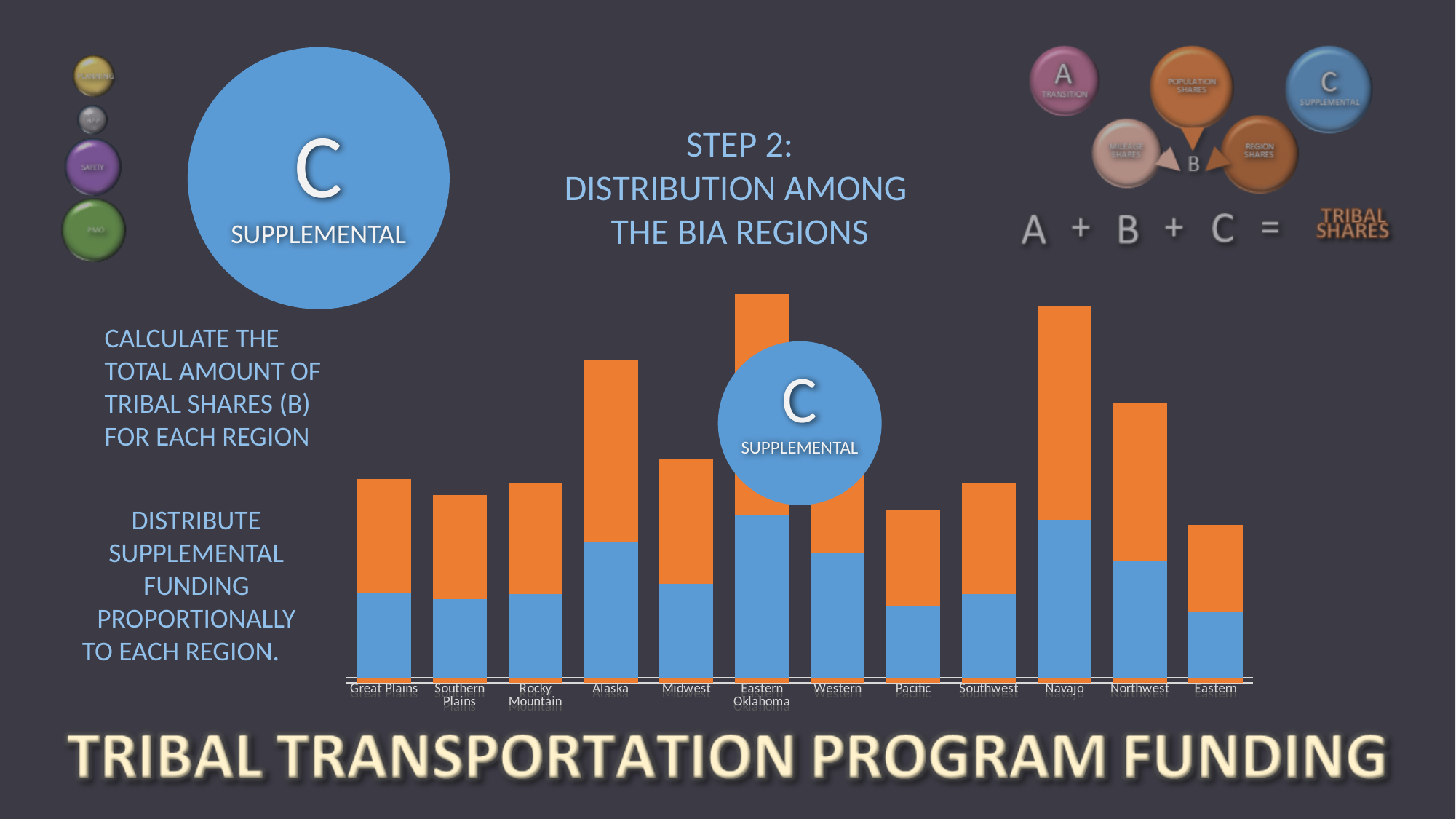
Which region has the tallest stacked bar in the chart? Eastern Oklahoma How many BIA regions are shown along the x axis of the chart? 12 Which region has the shortest stacked bar in the chart? Eastern Which region has the taller stacked bar, Alaska or Midwest? Alaska What is the first region listed on the x axis of the chart? Great Plains Which region has the taller stacked bar, Western or Rocky Mountain? Western Which region has the taller stacked bar, Navajo or Northwest? Navajo What kind of chart is shown on the slide? Stacked bar chart What two colours are used for the segments of the stacked bars? Blue and orange